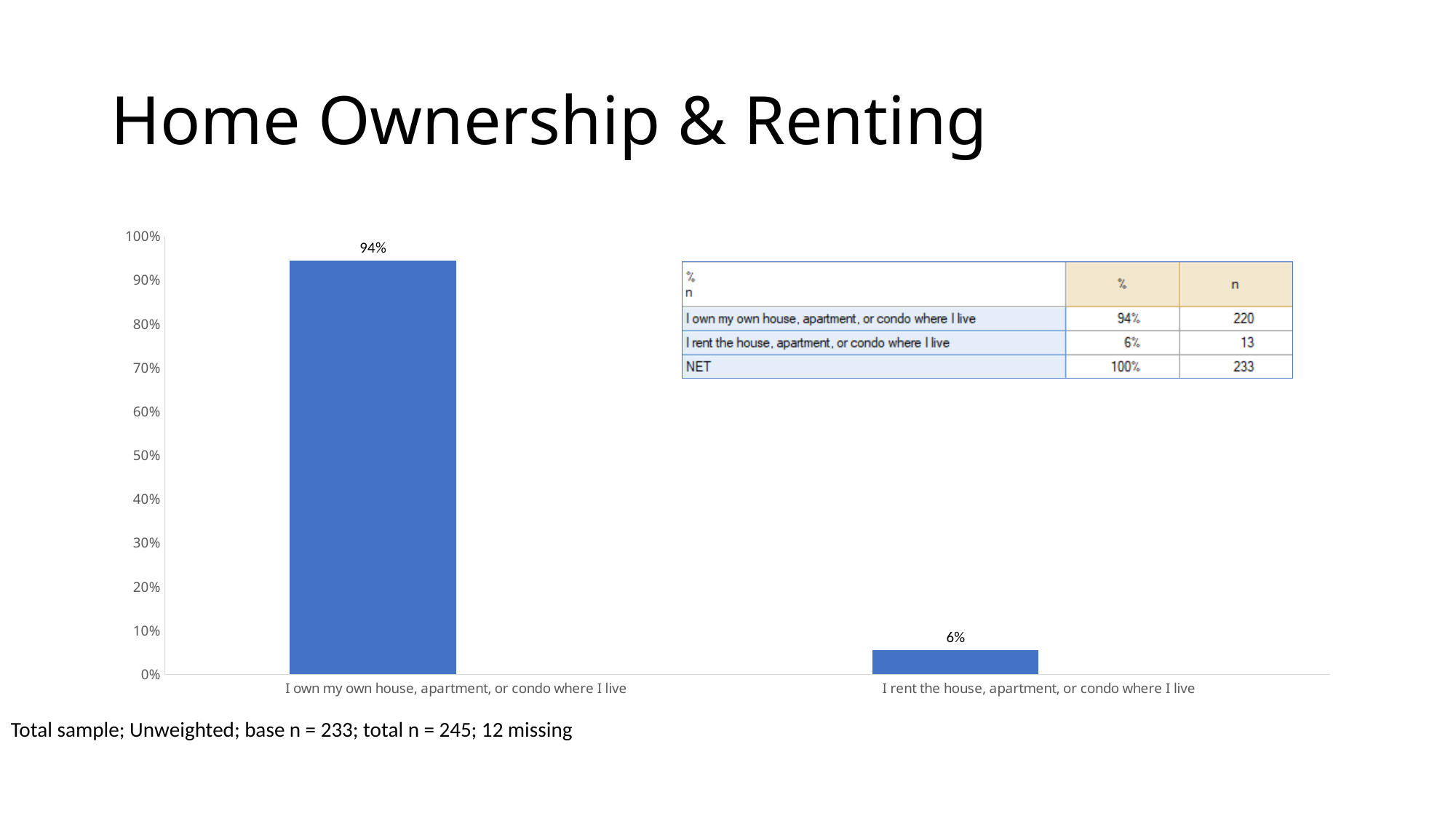
What is the title of the slide containing the chart? Home Ownership & Renting What percentage of respondents rent the house, apartment, or condo where they live? 6% What percentage of respondents own their own house, apartment, or condo where they live? 94% Which category has the lowest value in the chart? I rent the house, apartment, or condo where I live What type of chart is shown on the slide? Bar chart Is the value for 'I own my own house, apartment, or condo where I live' greater or less than 90%? greater Which is larger: the share who own their home or the share who rent? I own my own house, apartment, or condo where I live Is the value for 'I rent the house, apartment, or condo where I live' greater or less than 10%? less How many categories are shown on the x axis of the chart? 2 Which category has the highest value in the chart? I own my own house, apartment, or condo where I live What is the difference in percentage points between those who own and those who rent? 88 What is the maximum value shown on the y axis of the chart? 100%